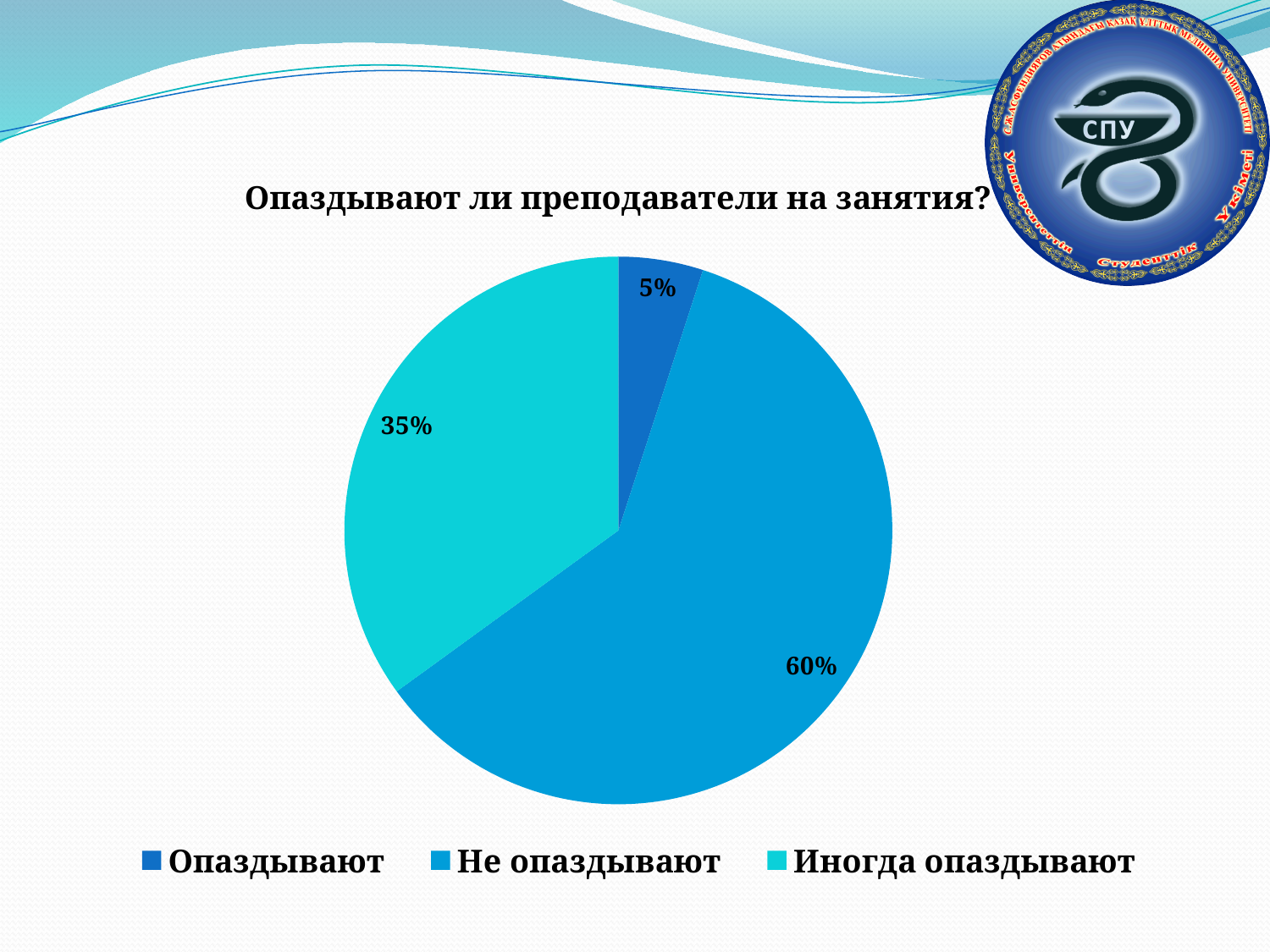
Which category has the smallest slice of the pie? Опаздывают What is the title of the chart? Опаздывают ли преподаватели на занятия? What share of the pie is labelled "Опаздывают"? 5% What is the difference between the shares for "Иногда опаздывают" and "Опаздывают"? 30% Which category has the largest slice of the pie? Не опаздывают How many entries does the legend list? 3 What kind of chart is shown on the slide? pie chart What share of the pie is labelled "Не опаздывают"? 60% What share of the pie is labelled "Иногда опаздывают"? 35% Which is larger: the share for "Иногда опаздывают" or the share for "Опаздывают"? Иногда опаздывают How many categories does the pie chart have? 3 What is the difference between the shares for "Не опаздывают" and "Иногда опаздывают"? 25%